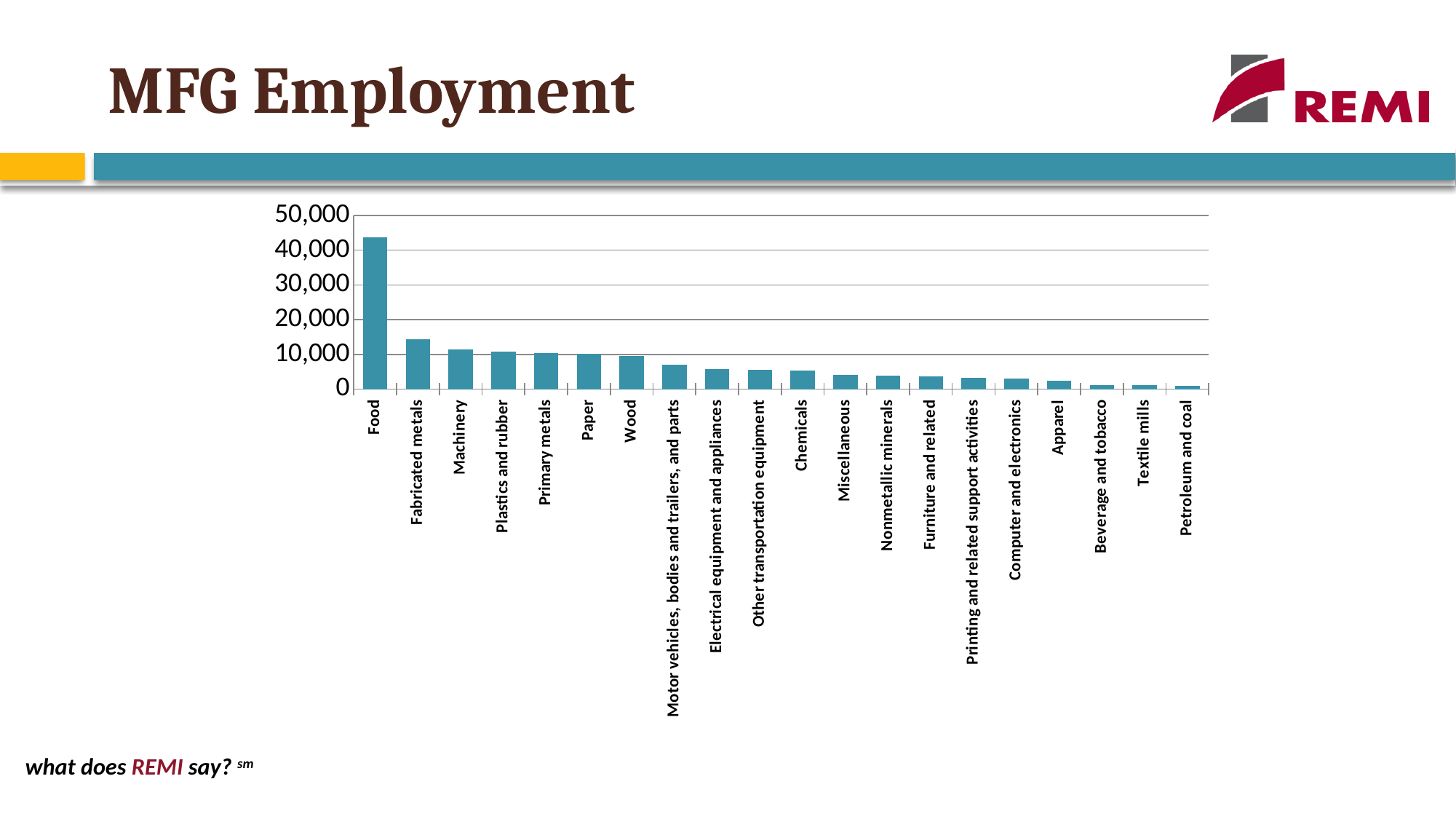
Which industry has the highest employment in the chart? Food Which is larger, the value for Fabricated metals or the value for Machinery? Fabricated metals Which is larger, the value for Food or the value for Fabricated metals? Food Is the value for Motor vehicles, bodies and trailers, and parts greater or less than 10,000? less How many categories (industries) are plotted in the chart? 20 What kind of chart is shown on the slide? bar chart Is the value for Fabricated metals greater or less than 10,000? greater Do the bar values rise or fall moving from left to right along the x axis? fall Which is larger, the value for Chemicals or the value for Apparel? Chemicals Is the value for Petroleum and coal greater or less than 10,000? less What is the title of the slide containing the chart? MFG Employment